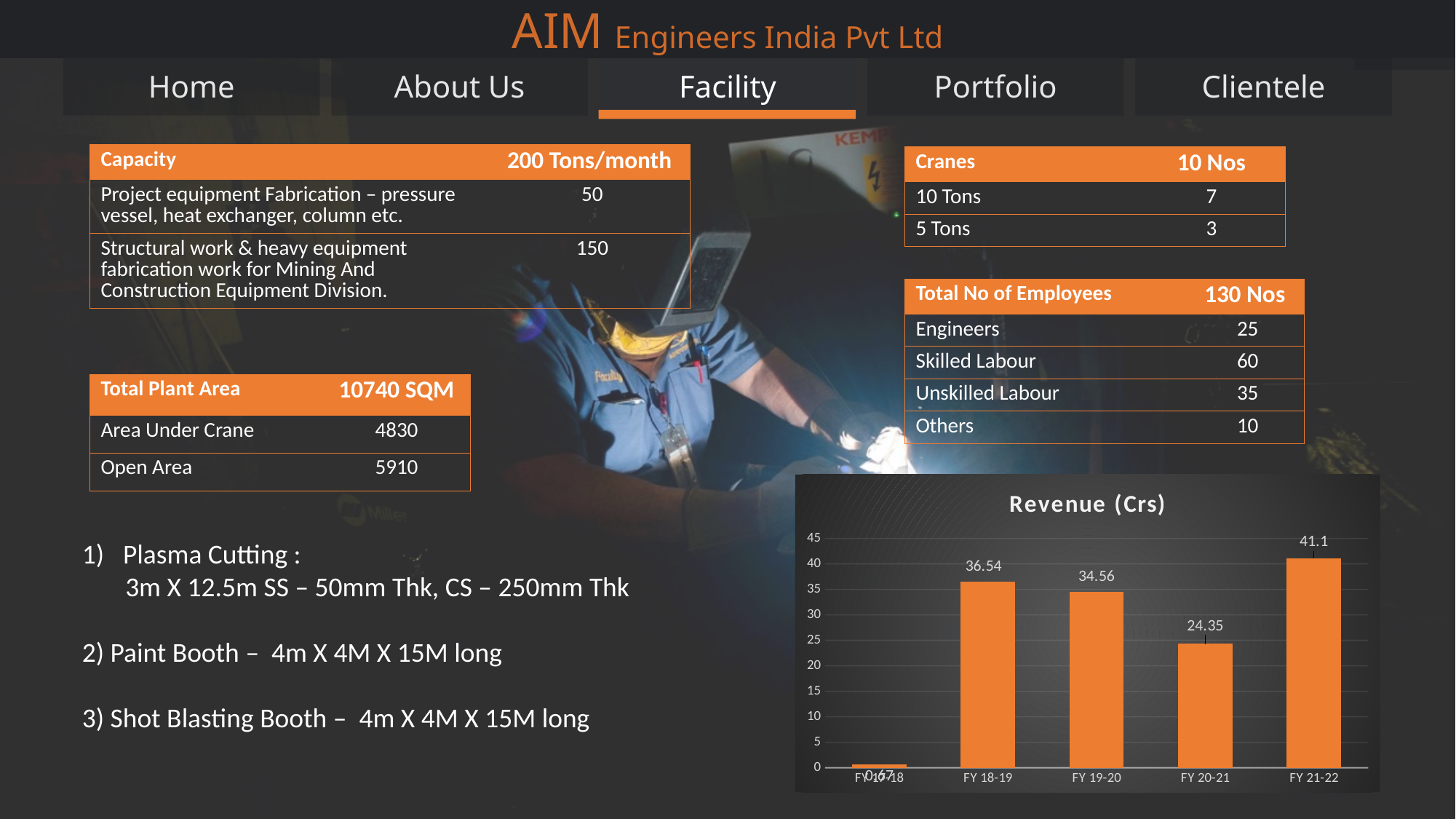
Which fiscal year has the lowest revenue in the Revenue (Crs) chart? FY 17-18 In the Revenue (Crs) chart, what is the value for FY 18-19? 36.54 How many fiscal years are shown in the Revenue (Crs) chart? 5 In the Revenue (Crs) chart, what is the value for FY 19-20? 34.56 In the Revenue (Crs) chart, what is the value for FY 21-22? 41.1 In the Revenue (Crs) chart, what is the difference between the values for FY 19-20 and FY 20-21? 10.21 What is the title of the chart on the slide? Revenue (Crs) Which fiscal year has the highest revenue in the Revenue (Crs) chart? FY 21-22 In the Revenue (Crs) chart, what is the difference between the values for FY 21-22 and FY 18-19? 4.56 What type of chart is used to show Revenue (Crs)? bar chart In the Revenue (Crs) chart, what is the value for FY 20-21? 24.35 In the Revenue (Crs) chart, which is larger: the value for FY 20-21 or FY 19-20? FY 19-20